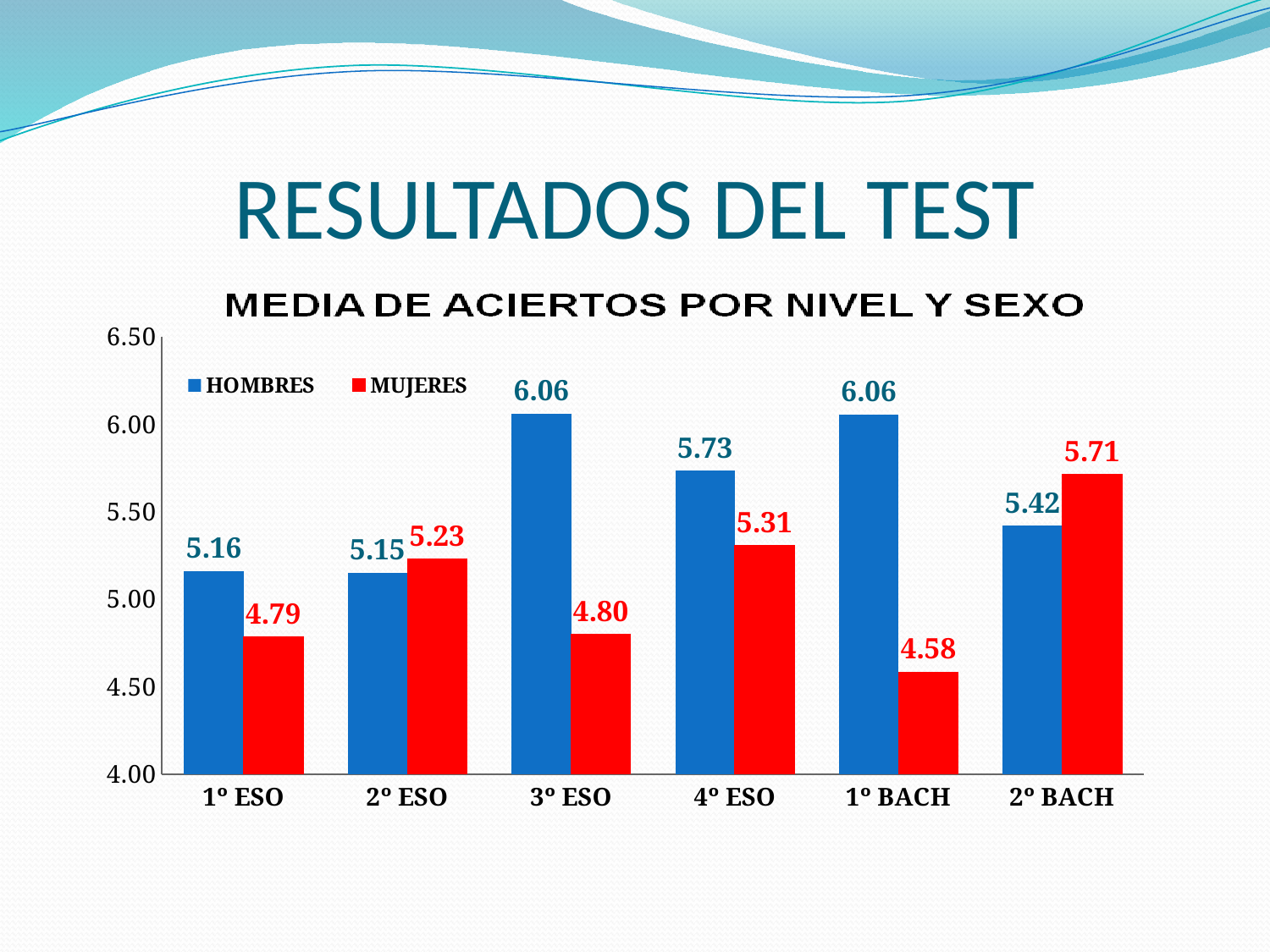
What is the value for HOMBRES in 4º ESO? 5.73 How many categories are shown on the x axis? 6 What is the title of the chart? MEDIA DE ACIERTOS POR NIVEL Y SEXO Which category has the lowest value for MUJERES? 1º BACH What is the value for HOMBRES in 3º ESO? 6.06 What kind of chart is shown on the slide? Bar chart How many series does the legend list? 2 Which category has the highest value for MUJERES? 2º BACH Which is larger in 2º BACH, HOMBRES or MUJERES? MUJERES What is the value for MUJERES in 1º BACH? 4.58 What is the difference between HOMBRES and MUJERES in 1º BACH? 1.48 What is the value for MUJERES in 2º BACH? 5.71